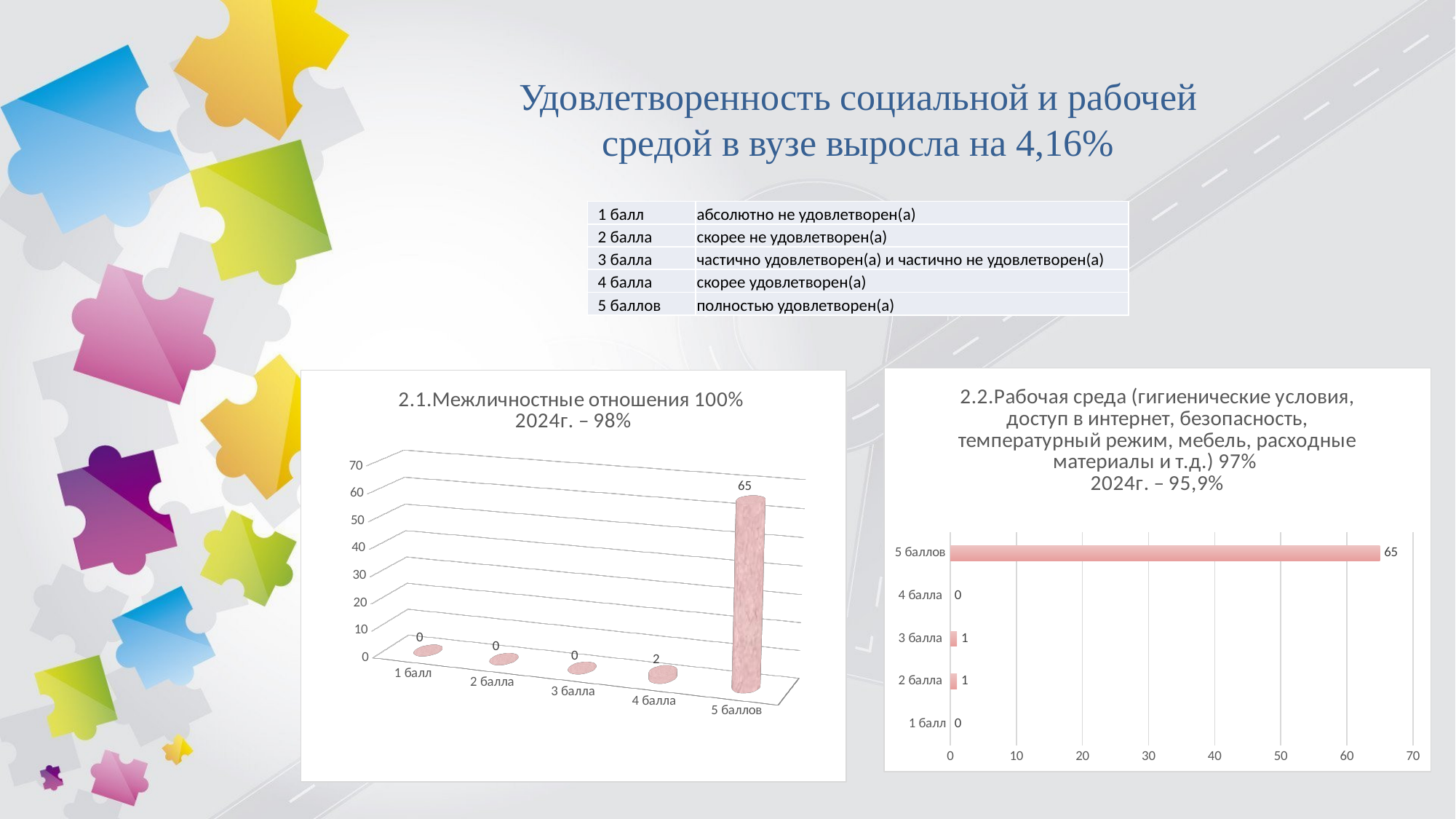
In the left chart (2.1. Межличностные отношения), what is the value for 4 балла? 2 In the left chart (2.1. Межличностные отношения), how many categories are shown on the x axis? 5 In the right chart (2.2. Рабочая среда), is the value for 5 баллов greater or less than 60? greater In the left chart (2.1. Межличностные отношения), which category has the highest value? 5 баллов In the left chart (2.1. Межличностные отношения), what is the value for 5 баллов? 65 In the right chart (2.2. Рабочая среда), what is the value for 3 балла? 1 In the left chart (2.1. Межличностные отношения), what is the difference between the values for 5 баллов and 4 балла? 63 In the right chart (2.2. Рабочая среда), what is the value for 4 балла? 0 What type of chart is the left chart (2.1. Межличностные отношения)? bar chart In the right chart (2.2. Рабочая среда), what is the value for 5 баллов? 65 What type of chart is the right chart (2.2. Рабочая среда)? bar chart In the right chart (2.2. Рабочая среда), which is larger: the value for 2 балла or the value for 5 баллов? 5 баллов